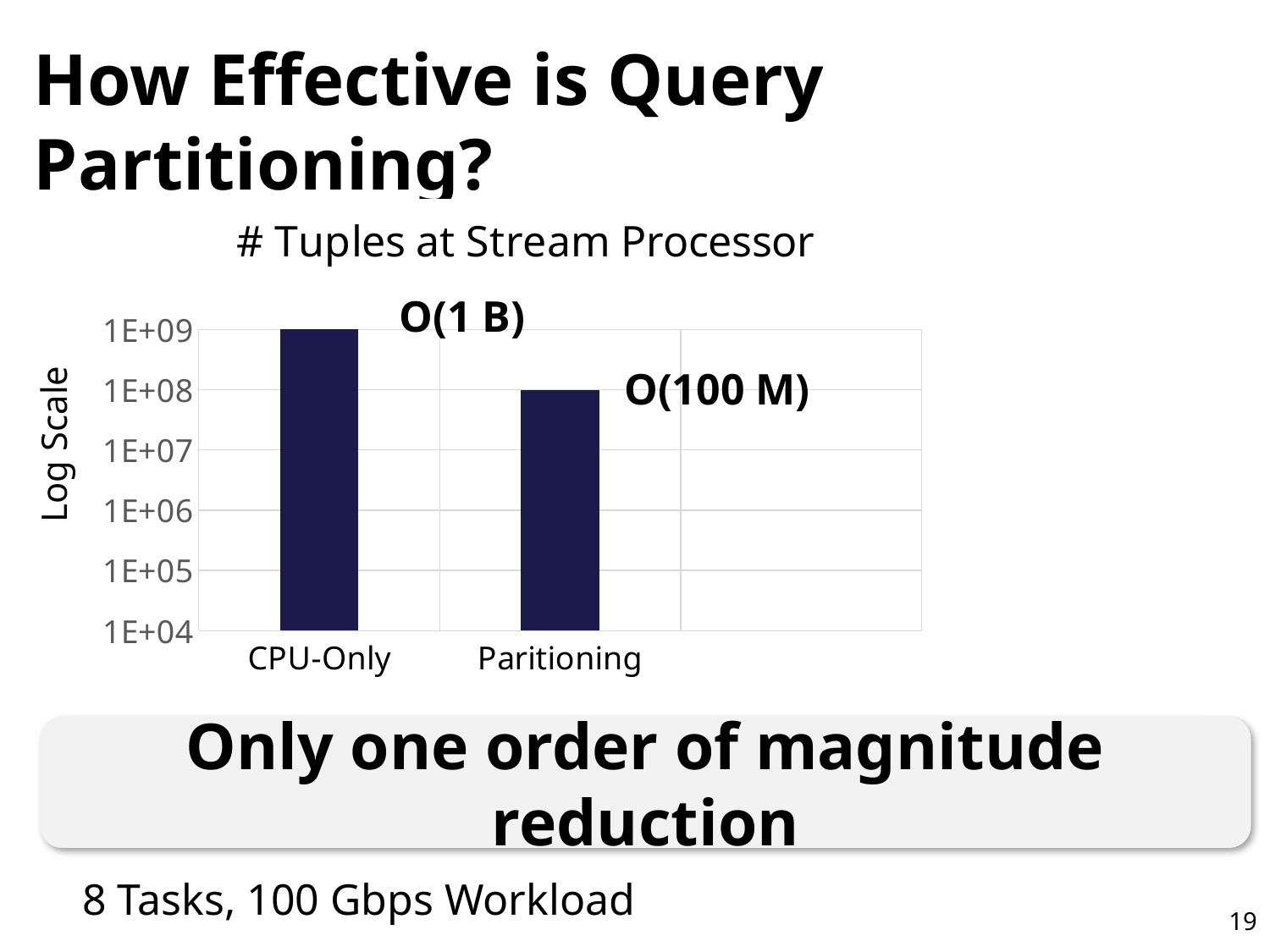
Which category has the highest number of tuples at the stream processor? CPU-Only Which axis tick does the Paritioning bar reach on the y axis? 1E+08 How many bars (categories) does the chart show? 2 Is the value for Paritioning greater or less than 1E+09? less Which category has the lowest number of tuples at the stream processor? Paritioning Which is larger, the value for CPU-Only or the value for Paritioning? CPU-Only What is the label on the y axis of the chart? Log Scale What annotation label is printed next to the Paritioning bar? O(100 M) What type of chart is shown on the slide? bar chart What is the title of the chart? # Tuples at Stream Processor What annotation label is printed next to the CPU-Only bar? O(1 B) Which axis tick does the CPU-Only bar reach on the y axis? 1E+09